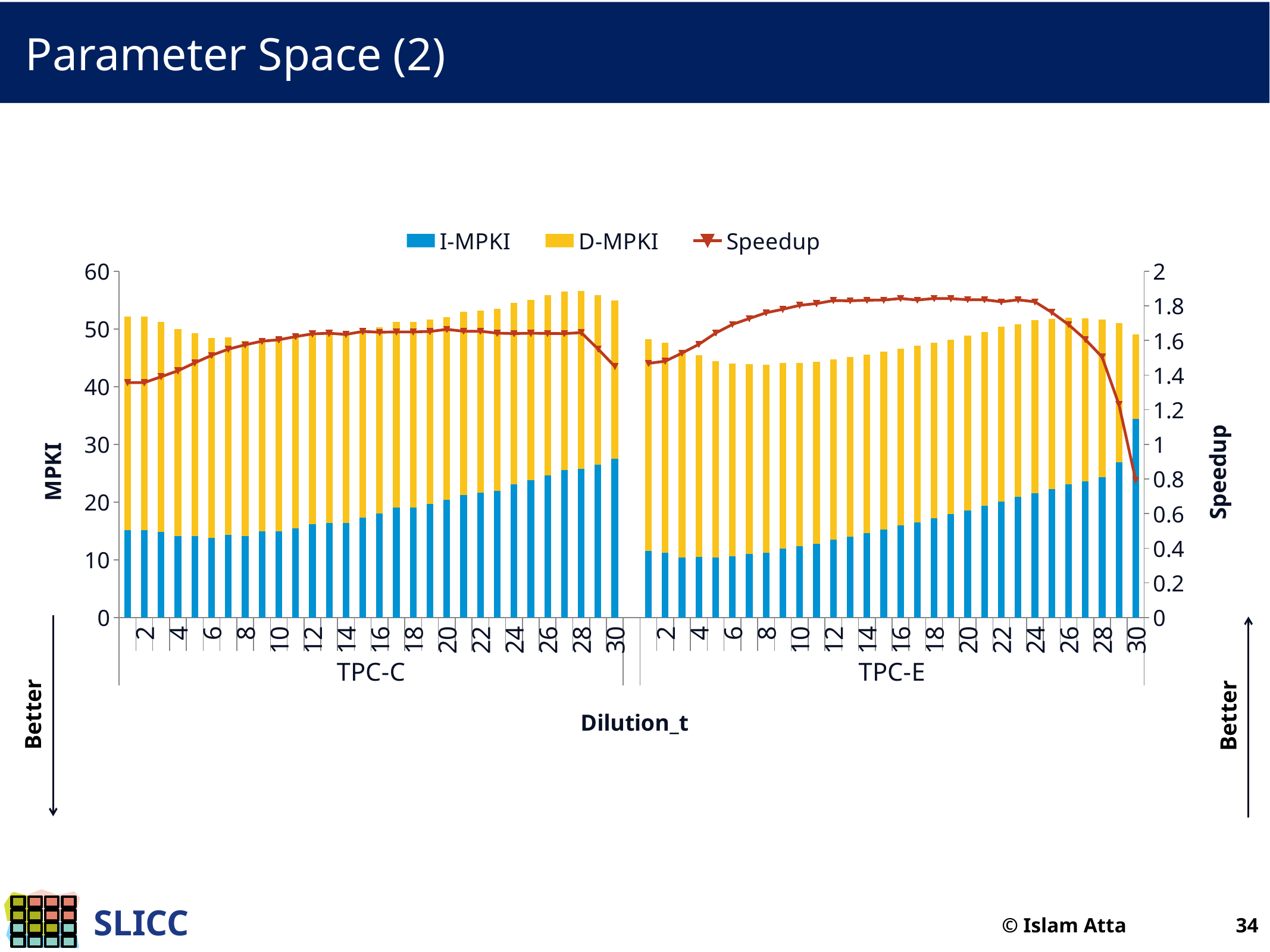
Is the Speedup value for TPC-E at Dilution_t 30 greater or less than 1? less What is the title of the x axis? Dilution_t How many series does the legend list? 3 Is the I-MPKI value for TPC-E at Dilution_t 4 greater or less than 20? less Is the Speedup value for TPC-E at Dilution_t 20 greater or less than 1.6? greater Which is larger: the Speedup for TPC-C at Dilution_t 30 or the Speedup for TPC-E at Dilution_t 30? TPC-C at Dilution_t 30 What kind of chart is this? Stacked bar chart with a line How many benchmark groups are shown on the x axis? 2 At which Dilution_t value is the Speedup for TPC-E lowest? 30 Does the I-MPKI for TPC-E rise or fall as Dilution_t increases? rise How many bars are plotted in the TPC-C group? 30